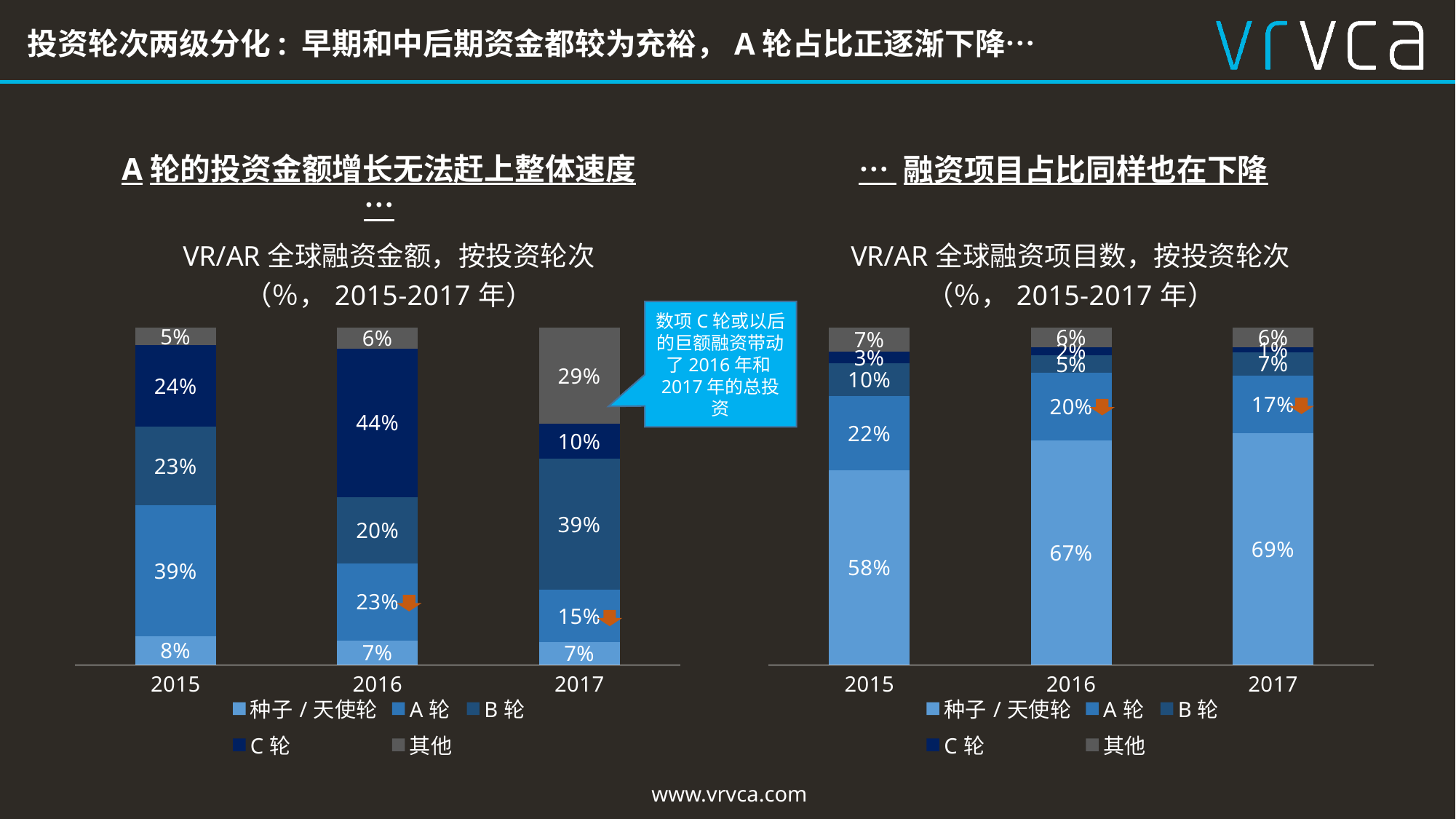
In the left chart (VR/AR 全球融资金额，按投资轮次), what is the value for C 轮 in 2017? 10% What kind of chart is the right chart (VR/AR 全球融资项目数，按投资轮次)? stacked bar chart In the left chart (VR/AR 全球融资金额，按投资轮次), what is the difference between the A 轮 value in 2015 and in 2017? 24% In the right chart (VR/AR 全球融资项目数，按投资轮次), what is the value for B 轮 in 2015? 10% In the left chart (VR/AR 全球融资金额，按投资轮次), does the A 轮 share rise or fall from 2015 to 2017? fall In the left chart (VR/AR 全球融资金额，按投资轮次), which year has the highest value for C 轮? 2016 In the left chart (VR/AR 全球融资金额，按投资轮次), what is the value for A 轮 in 2016? 23% In the right chart (VR/AR 全球融资项目数，按投资轮次), what is the value for 种子 / 天使轮 in 2017? 69% How many years are shown on the x axis of the right chart (VR/AR 全球融资项目数，按投资轮次)? 3 In the right chart (VR/AR 全球融资项目数，按投资轮次), which year has the lowest value for 种子 / 天使轮? 2015 In the right chart (VR/AR 全球融资项目数，按投资轮次), which is larger: the A 轮 value in 2015 or in 2016? 2015 How many series does the legend of the left chart (VR/AR 全球融资金额，按投资轮次) list? 5